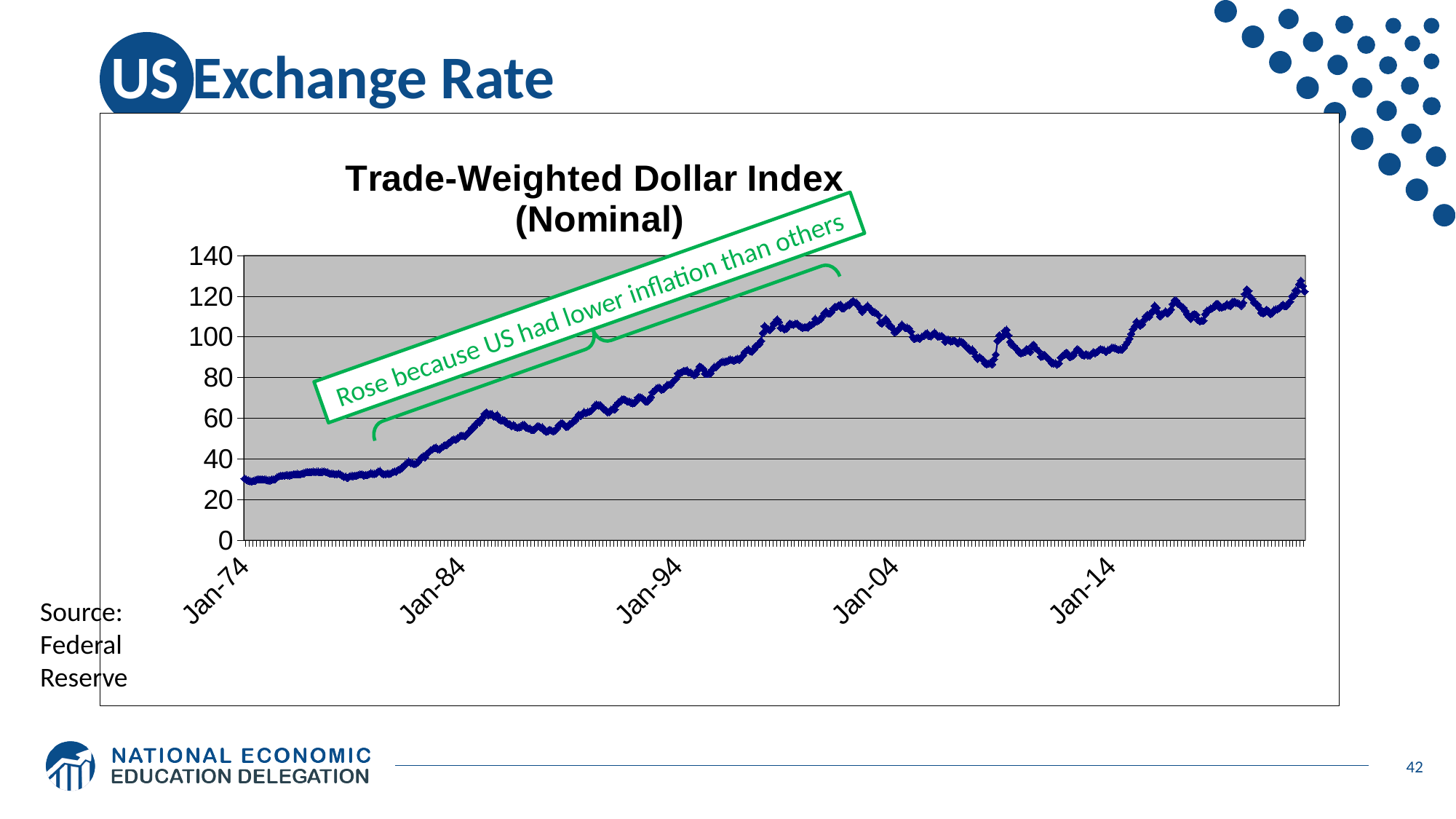
Is the value of the Trade-Weighted Dollar Index at Jan-14 greater or less than 120? less How many year labels are shown on the x axis of the chart? 5 What does the green annotation on the chart say? Rose because US had lower inflation than others What kind of chart is shown on the slide? Line chart Is the Trade-Weighted Dollar Index higher at the end of the series or at Jan-74? At the end of the series What is the title of the chart? Trade-Weighted Dollar Index (Nominal) Is the value of the Trade-Weighted Dollar Index at Jan-04 greater or less than 80? greater Overall, does the Trade-Weighted Dollar Index rise or fall from the start of the series to the end? Rise Is the value of the Trade-Weighted Dollar Index at Jan-74 greater or less than 40? less Does the Trade-Weighted Dollar Index rise or fall between Jan-74 and Jan-84? Rise